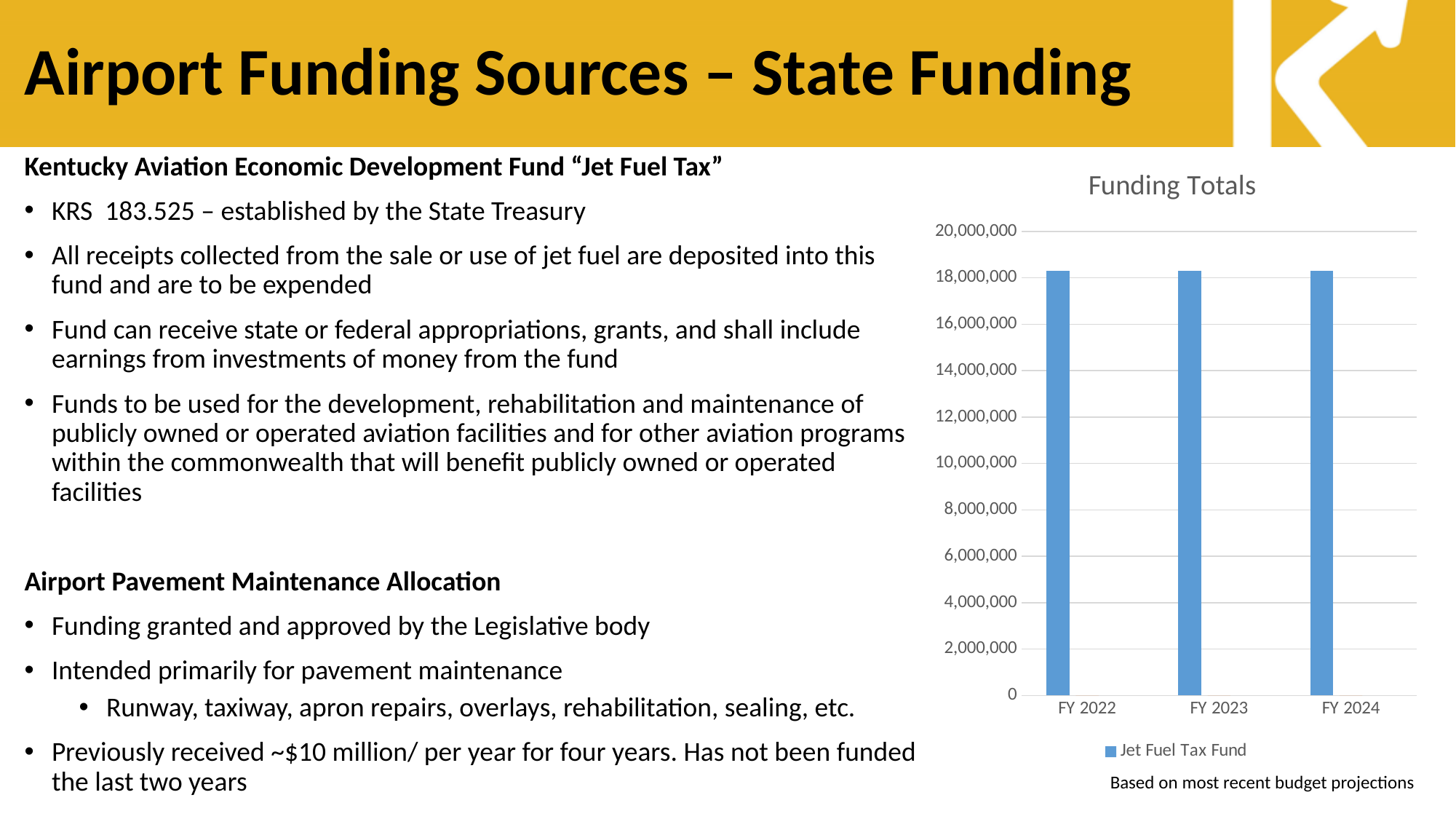
Is the value for FY 2022 in the Funding Totals chart greater or less than 16,000,000? greater Which fiscal year is the first category on the x axis of the Funding Totals chart? FY 2022 Do the values in the Funding Totals chart rise, fall, or stay roughly the same from FY 2022 to FY 2024? stay roughly the same What is the title of the chart on the slide? Funding Totals What series name appears in the legend of the Funding Totals chart? Jet Fuel Tax Fund What kind of chart is shown on the slide? bar chart How many series does the legend of the Funding Totals chart list? 1 What is the highest value shown on the y axis of the Funding Totals chart? 20,000,000 Is the value for FY 2024 in the Funding Totals chart greater or less than 14,000,000? greater Is the value for FY 2023 in the Funding Totals chart greater or less than 20,000,000? less How many categories (fiscal years) are shown on the x axis of the Funding Totals chart? 3